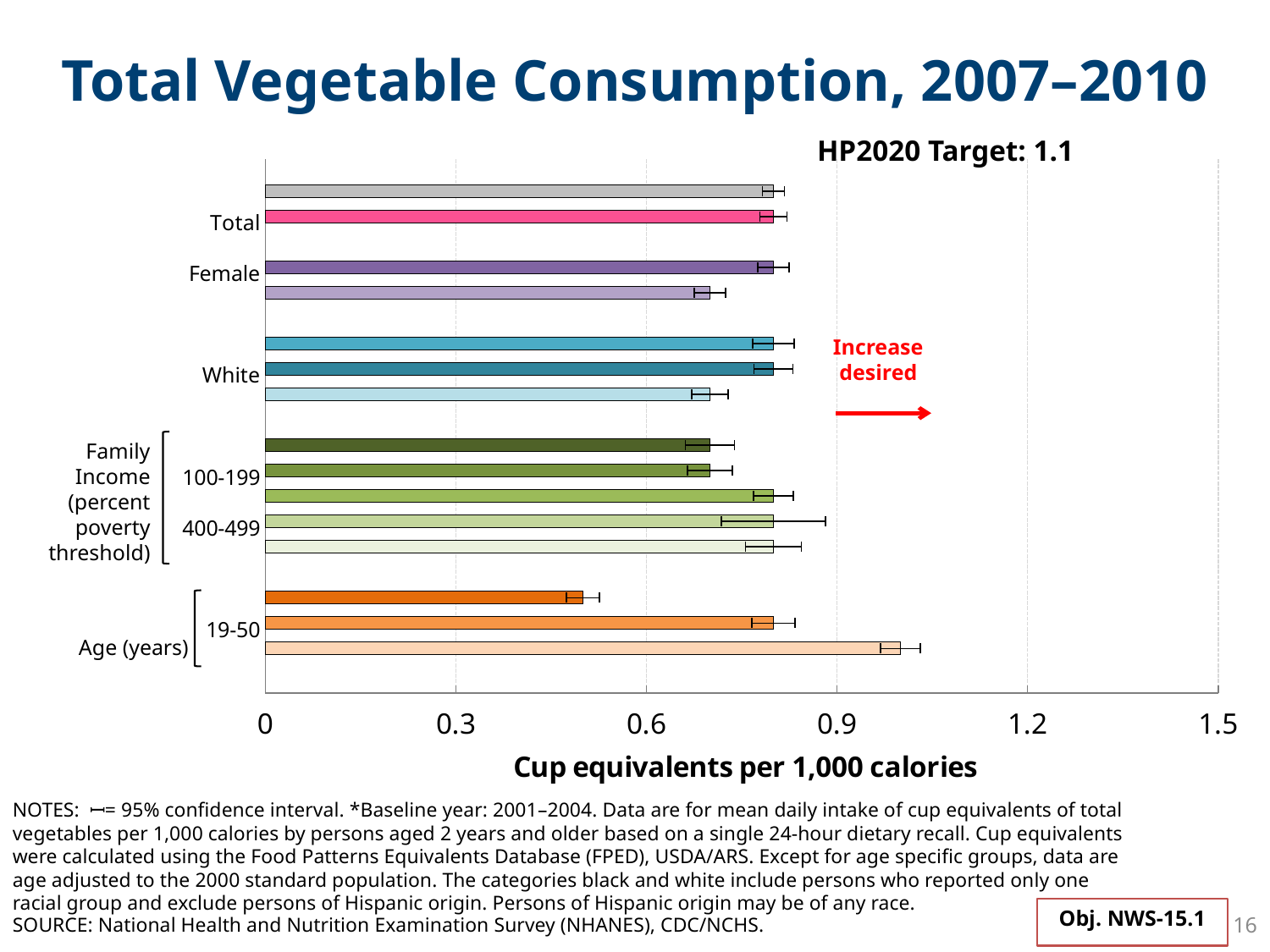
Is the value for the 100-199 family income group greater or less than 0.6? greater Is the value for the 400-499 family income group greater or less than 0.9? less Is the value for the 19-50 age group greater or less than 0.6? greater What kind of chart is shown on the slide? bar chart What is the title of the chart? Total Vegetable Consumption, 2007–2010 What is the label of the x axis? Cup equivalents per 1,000 calories What is the HP2020 Target shown on the chart? 1.1 Which is larger, the value for Total or the value for the 100-199 family income group? Total